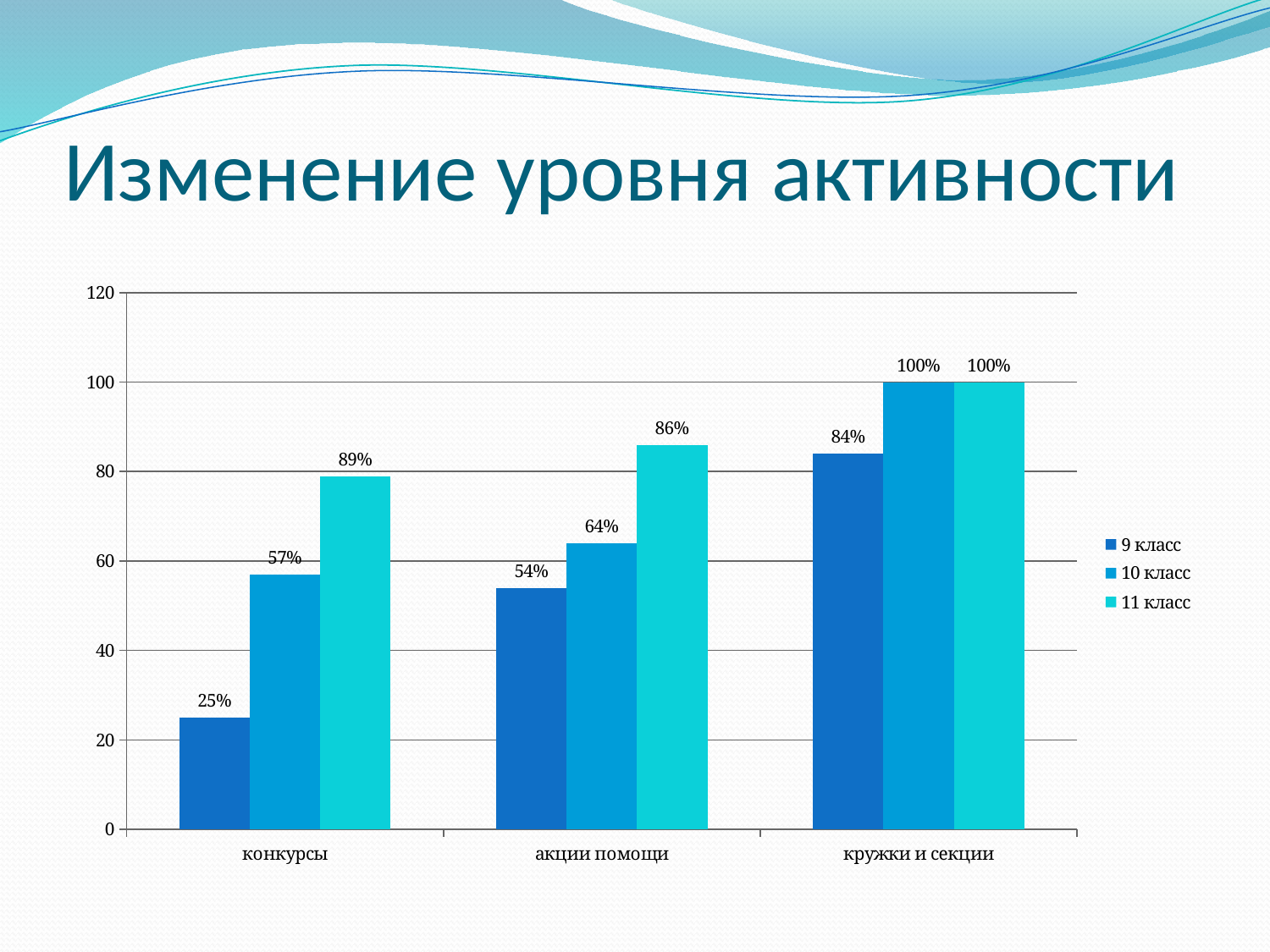
What is the value for 9 класс in the конкурсы category? 25% What is the value for 10 класс in the конкурсы category? 57% What is the value for 11 класс in the акции помощи category? 86% How many categories are shown on the x axis? 3 What is the title of the slide? Изменение уровня активности What kind of chart is shown on the slide? bar chart Which category has the highest value for 11 класс? кружки и секции What is the value for 10 класс in the кружки и секции category? 100% What is the difference between the 10 класс and 9 класс values in the акции помощи category? 10% How many series does the legend list? 3 Which category has the lowest value for 9 класс? конкурсы Which is larger: the 9 класс value for кружки и секции or the 11 класс value for акции помощи? 11 класс value for акции помощи